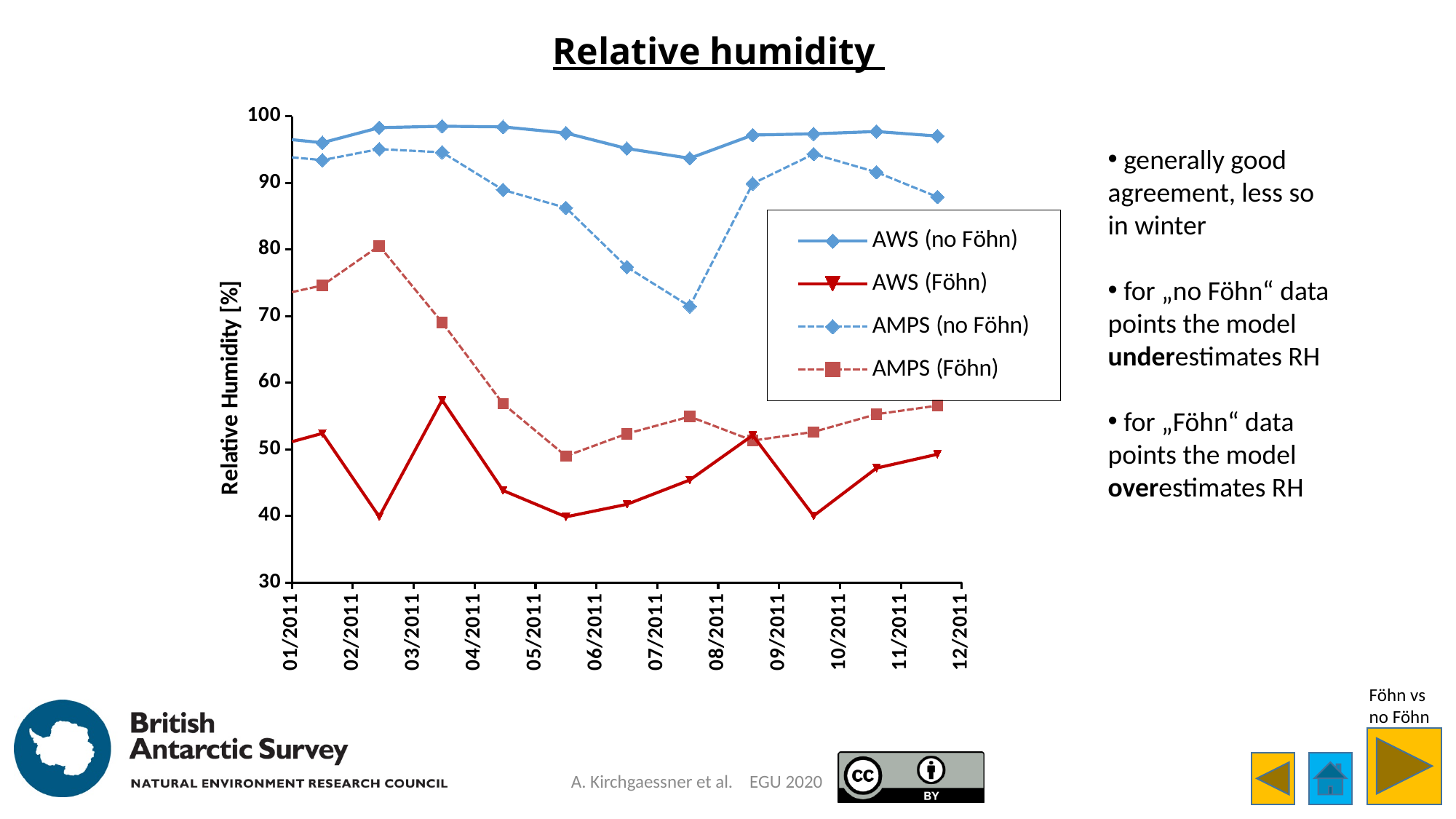
Is the value for AWS (no Föhn) at 01/2011 greater or less than 90? greater How many series does the legend list? 4 Is the lowest value of AMPS (no Föhn), reached between 07/2011 and 08/2011, greater or less than 80? less How many month labels are shown on the x axis? 12 Does the AMPS (no Föhn) series rise or fall between 03/2011 and 07/2011? fall What kind of chart is shown on the slide? line chart What is the label of the y axis? Relative Humidity [%] Is the value for AWS (Föhn) at 01/2011 greater or less than 60? less Around 02/2011, which is higher, AMPS (Föhn) or AWS (Föhn)? AMPS (Föhn) Which series has the highest values across the whole year? AWS (no Föhn) What is the title of the chart? Relative humidity Which series has the lowest values across the whole year? AWS (Föhn)